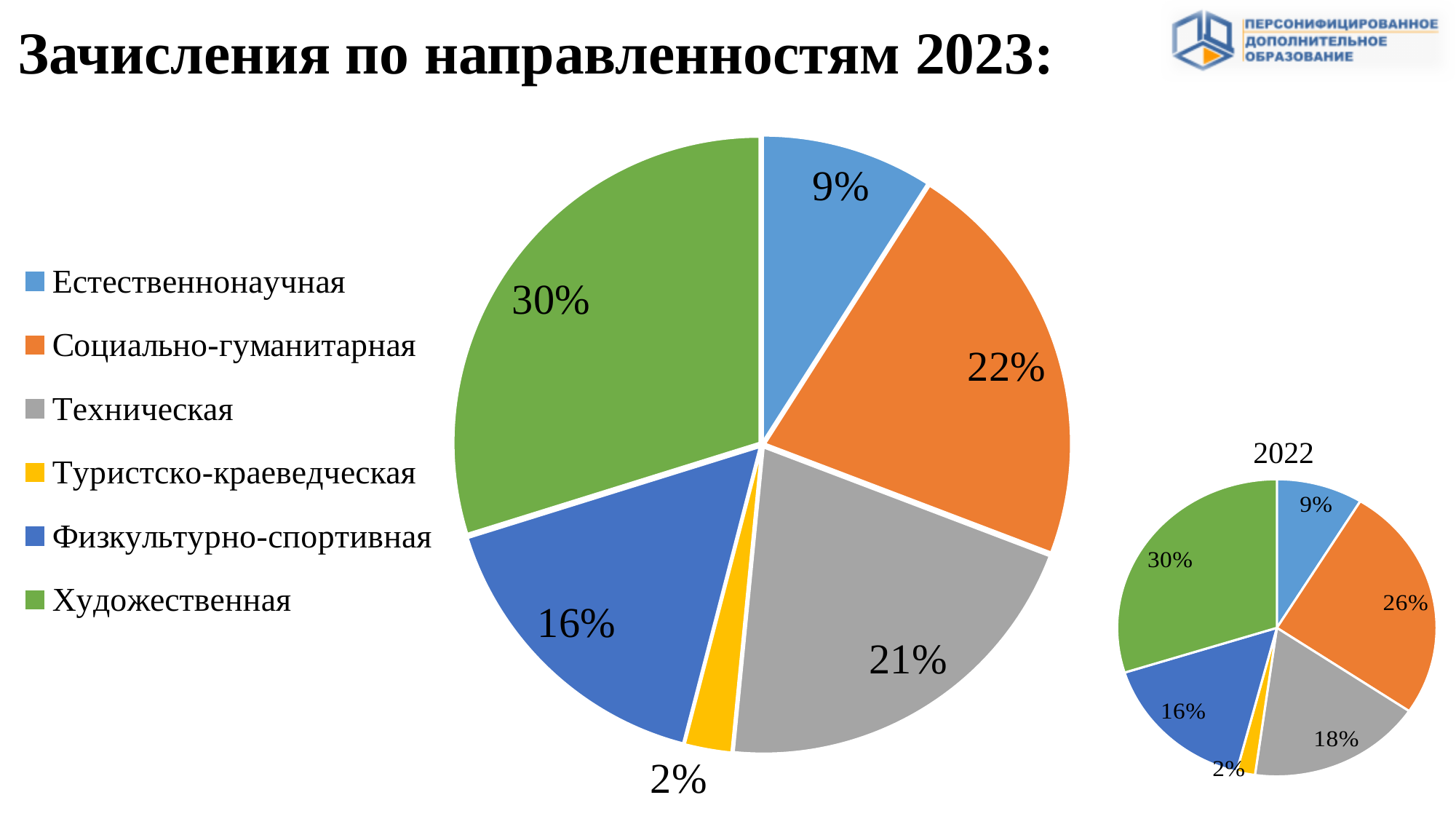
In the large 2023 pie chart, which category has the smallest share? Туристско-краеведческая In the large 2023 pie chart, which category has the largest share? Художественная In the large 2023 pie chart, what share does Техническая have? 21% In the small 2022 pie chart, what share does Техническая have? 18% In the large 2023 pie chart, what share does Художественная have? 30% In the small 2022 pie chart, which category has the largest share? Художественная How many categories does the legend list? 6 What type of chart is the large chart on the slide? Pie chart In the large 2023 pie chart, which is larger: Социально-гуманитарная or Естественнонаучная? Социально-гуманитарная In the large 2023 pie chart, what share does Социально-гуманитарная have? 22% In the large 2023 pie chart, what is the difference in percentage points between Художественная and Физкультурно-спортивная? 14 In the small 2022 pie chart, what share does Социально-гуманитарная have? 26%